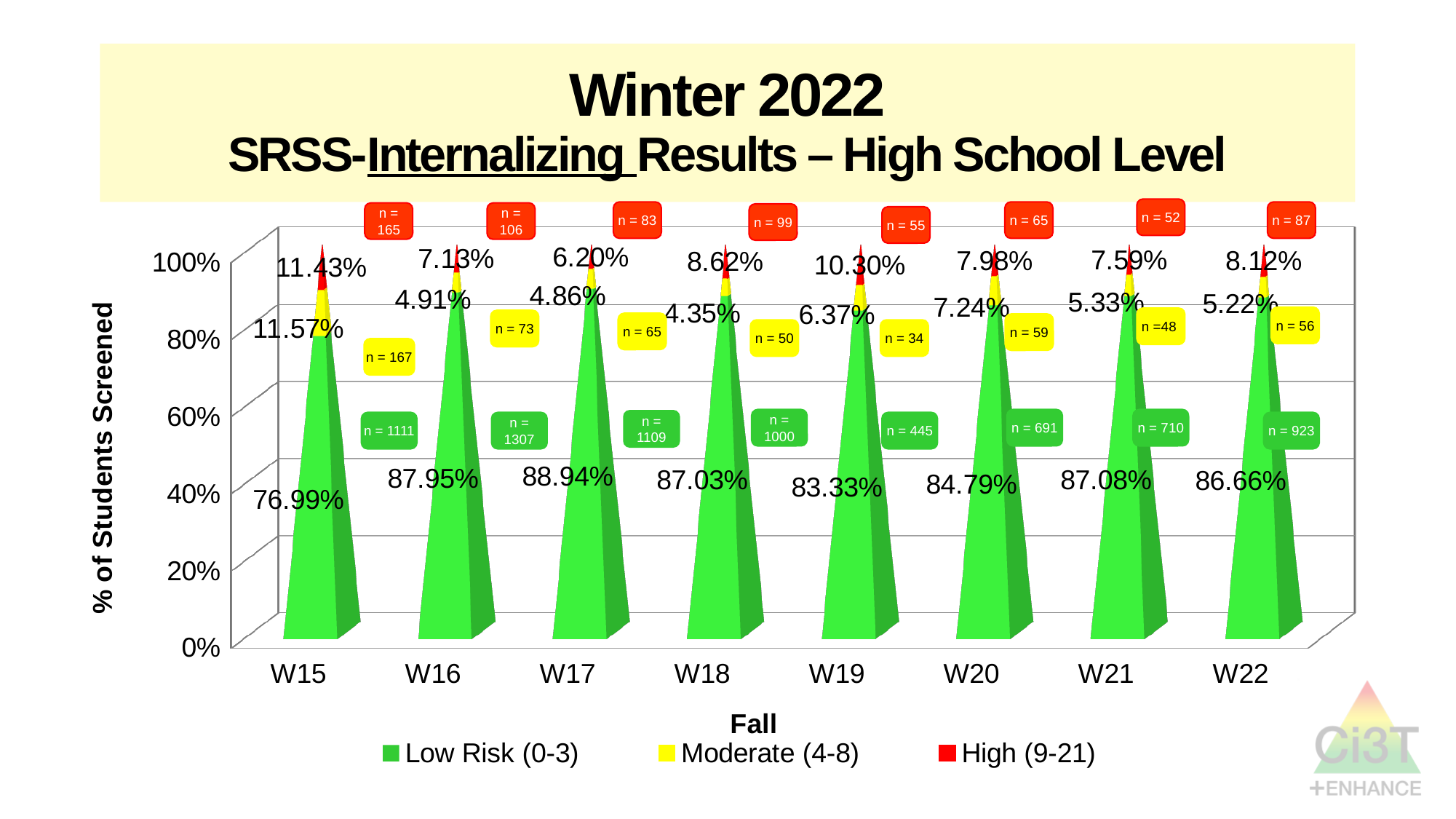
What is the Moderate (4-8) percentage for W20? 7.24% What kind of chart is shown? Stacked bar chart How many series does the legend list? 3 What is the label on the vertical axis? % of Students Screened What percentage of students were Low Risk (0-3) at W15? 76.99% Which school has the highest Low Risk (0-3) percentage? W17 How many schools are shown on the x axis? 8 What is the difference in Low Risk (0-3) percentage between W17 and W15? 11.95 percentage points Which school has the highest High (9-21) percentage? W15 Which is larger, the Low Risk (0-3) percentage for W16 or for W19? W16 What is the High (9-21) percentage for W19? 10.30% Which school has the lowest Low Risk (0-3) percentage? W15